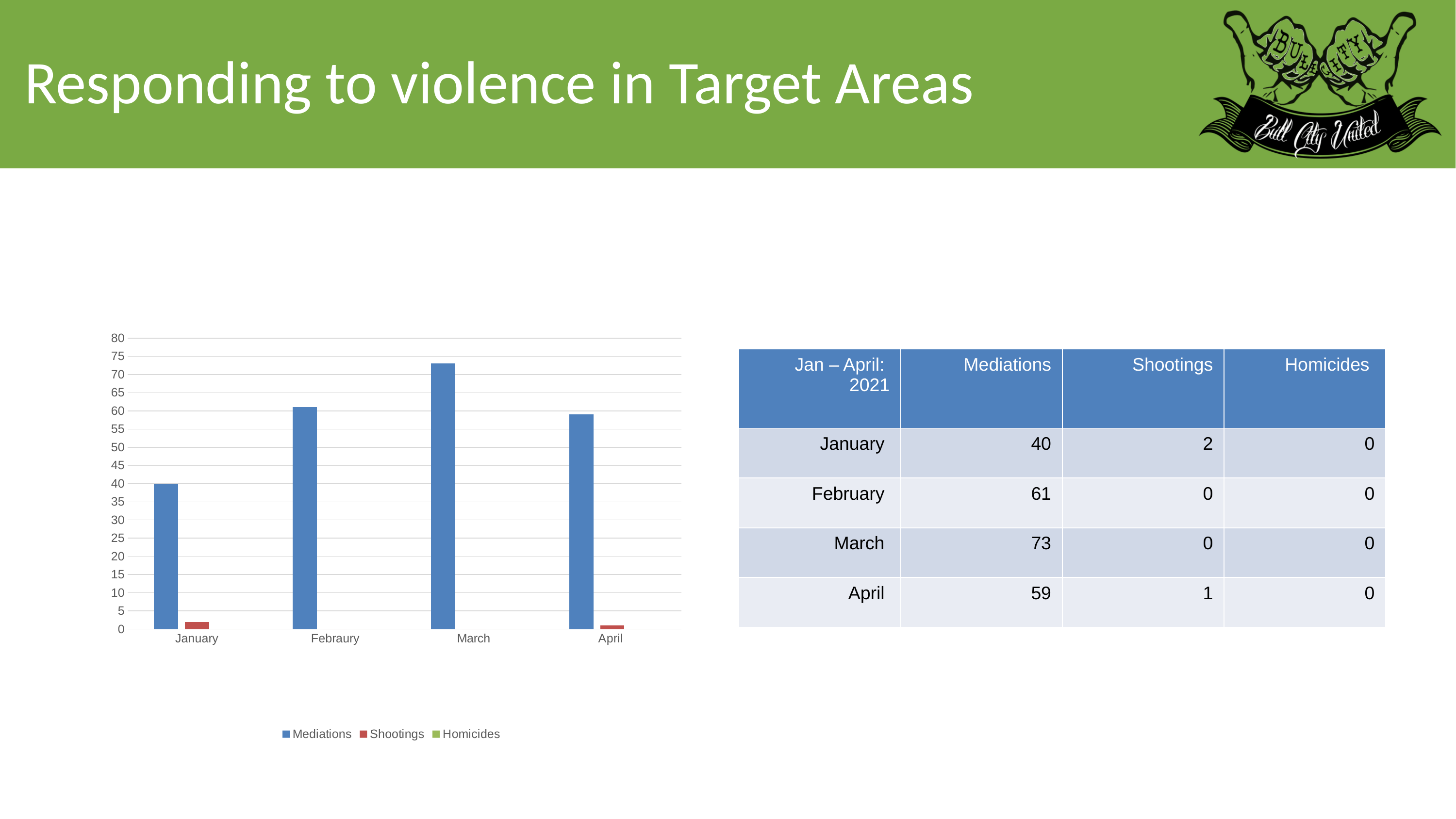
How many months are shown on the x axis of the chart? 4 What is the value of Shootings for January? 2 Which series in the legend is shown in red? Shootings What is the value of Mediations for January? 40 How many series does the chart legend list? 3 What kind of chart is shown on the slide? bar chart Which month has the lowest number of Mediations? January Which month has the highest number of Mediations? March What is the value of Mediations for March? 73 Which is larger, Mediations in February or Mediations in April? February What is the difference in Mediations between March and January? 33 Is the value of Mediations for February greater or less than 50? greater